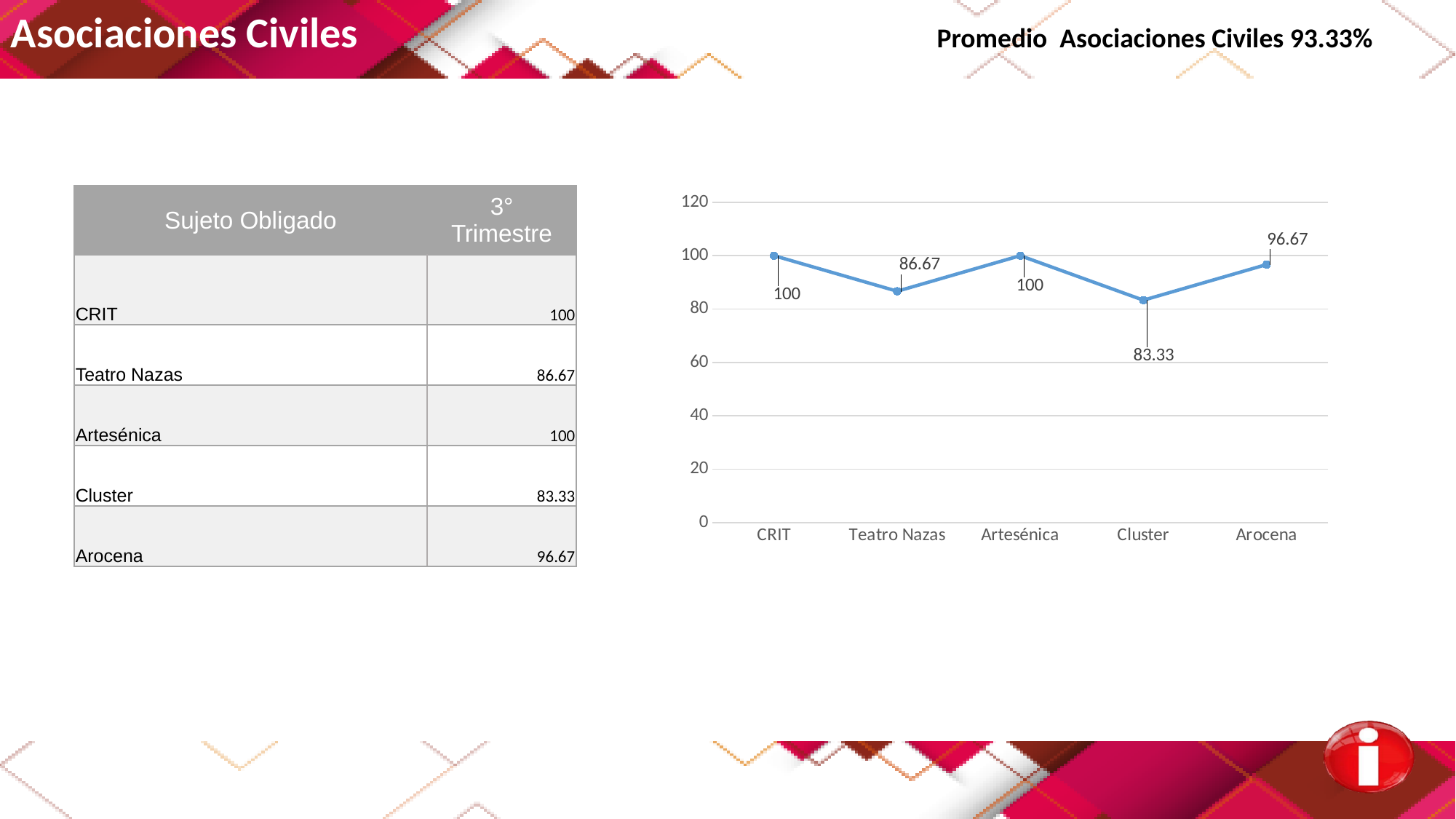
What is the value for CRIT in the chart? 100 How many categories are plotted on the x axis of the chart? 5 What is the value for Arocena in the chart? 96.67 What is the difference between the values for CRIT and Teatro Nazas? 13.33 Does the line rise or fall from Cluster to Arocena? rise Is the value for Cluster greater or less than 100? less What is the value for Teatro Nazas in the chart? 86.67 What is the value for Cluster in the chart? 83.33 Which is larger, the value for Teatro Nazas or the value for Arocena? Arocena What kind of chart is shown on the slide? line chart Which category has the lowest value in the chart? Cluster What is the difference between the values for Arocena and Cluster? 13.34